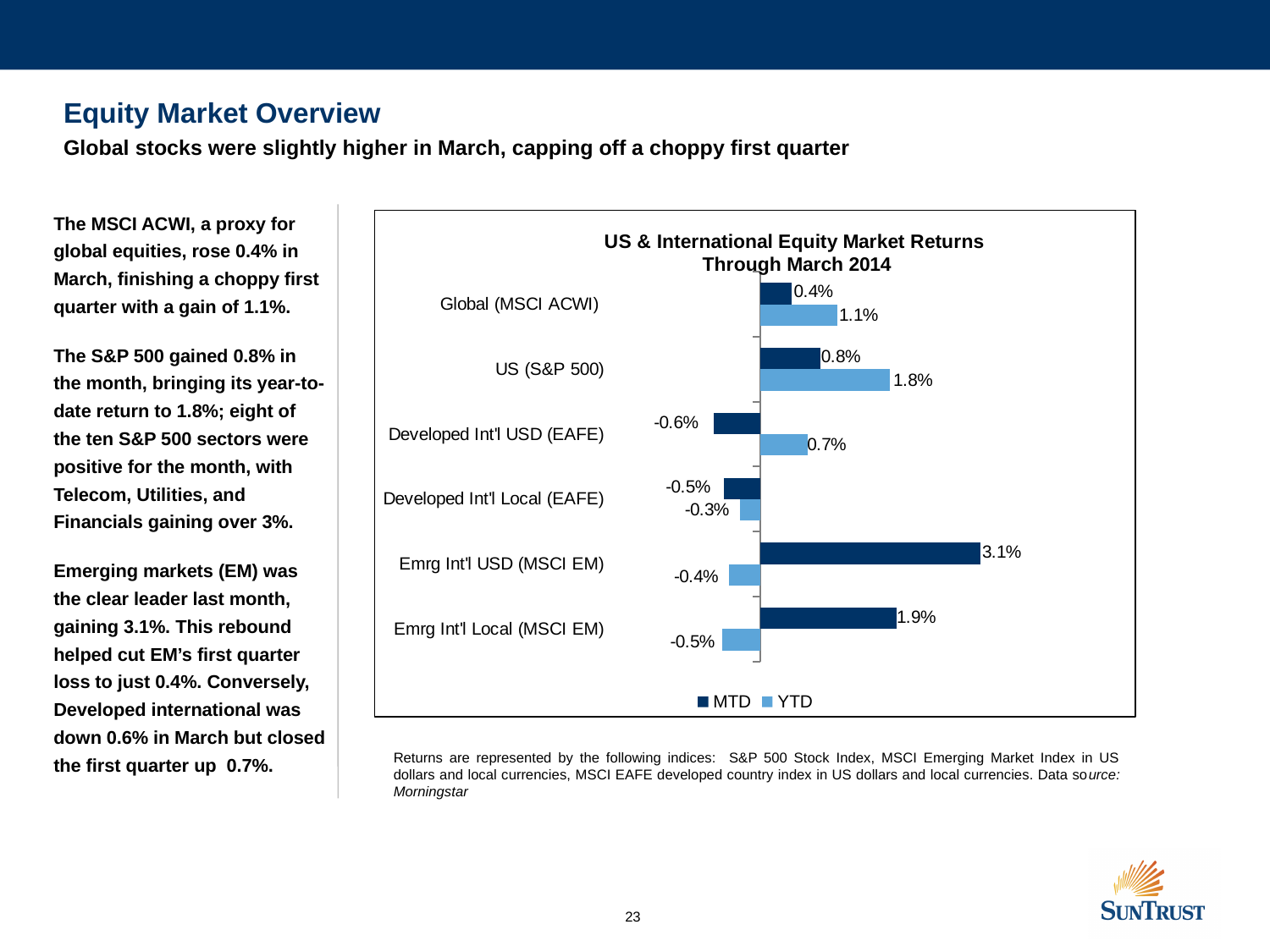
What is the MTD value for Global (MSCI ACWI)? 0.4% What is the YTD value for Emrg Int'l USD (MSCI EM)? -0.4% Which category has the lowest YTD value? Emrg Int'l Local (MSCI EM) What is the title of the chart? US & International Equity Market Returns Through March 2014 What is the MTD value for Developed Int'l USD (EAFE)? -0.6% What is the difference between the YTD and MTD values for US (S&P 500)? 1.0% What is the YTD value for US (S&P 500)? 1.8% How many series does the legend list? 2 What kind of chart is shown on the slide? Bar chart Which is larger, the MTD value for Emrg Int'l USD (MSCI EM) or the MTD value for Emrg Int'l Local (MSCI EM)? Emrg Int'l USD (MSCI EM) How many categories are shown on the chart? 6 Which category has the highest MTD value? Emrg Int'l USD (MSCI EM)